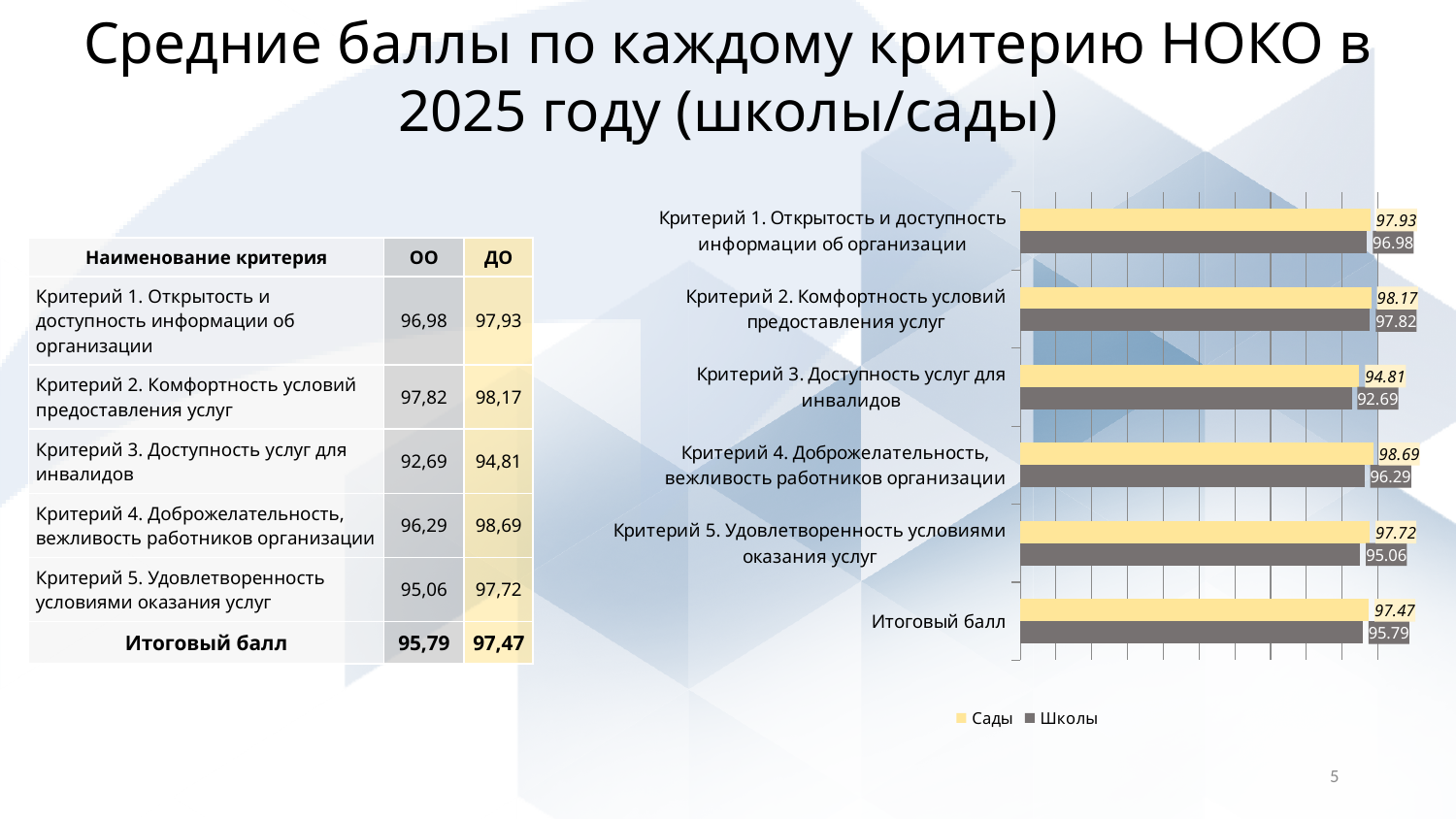
What is the difference between the Сады and Школы values for Итоговый балл? 1.68 What is the value for Сады for Критерий 1. Открытость и доступность информации об организации? 97.93 What type of chart is shown on the slide? bar chart How many categories are plotted on the chart? 6 Which is larger for Критерий 5. Удовлетворенность условиями оказания услуг: the value for Сады or for Школы? Сады What is the value for Школы for Итоговый балл? 95.79 Which series in the legend is shown in yellow? Сады What is the value for Школы for Критерий 3. Доступность услуг для инвалидов? 92.69 Which category has the lowest value for Школы? Критерий 3. Доступность услуг для инвалидов How many series does the chart legend list? 2 What is the difference between the Сады and Школы values for Критерий 4. Доброжелательность, вежливость работников организации? 2.40 Which category has the highest value for Сады? Критерий 4. Доброжелательность, вежливость работников организации